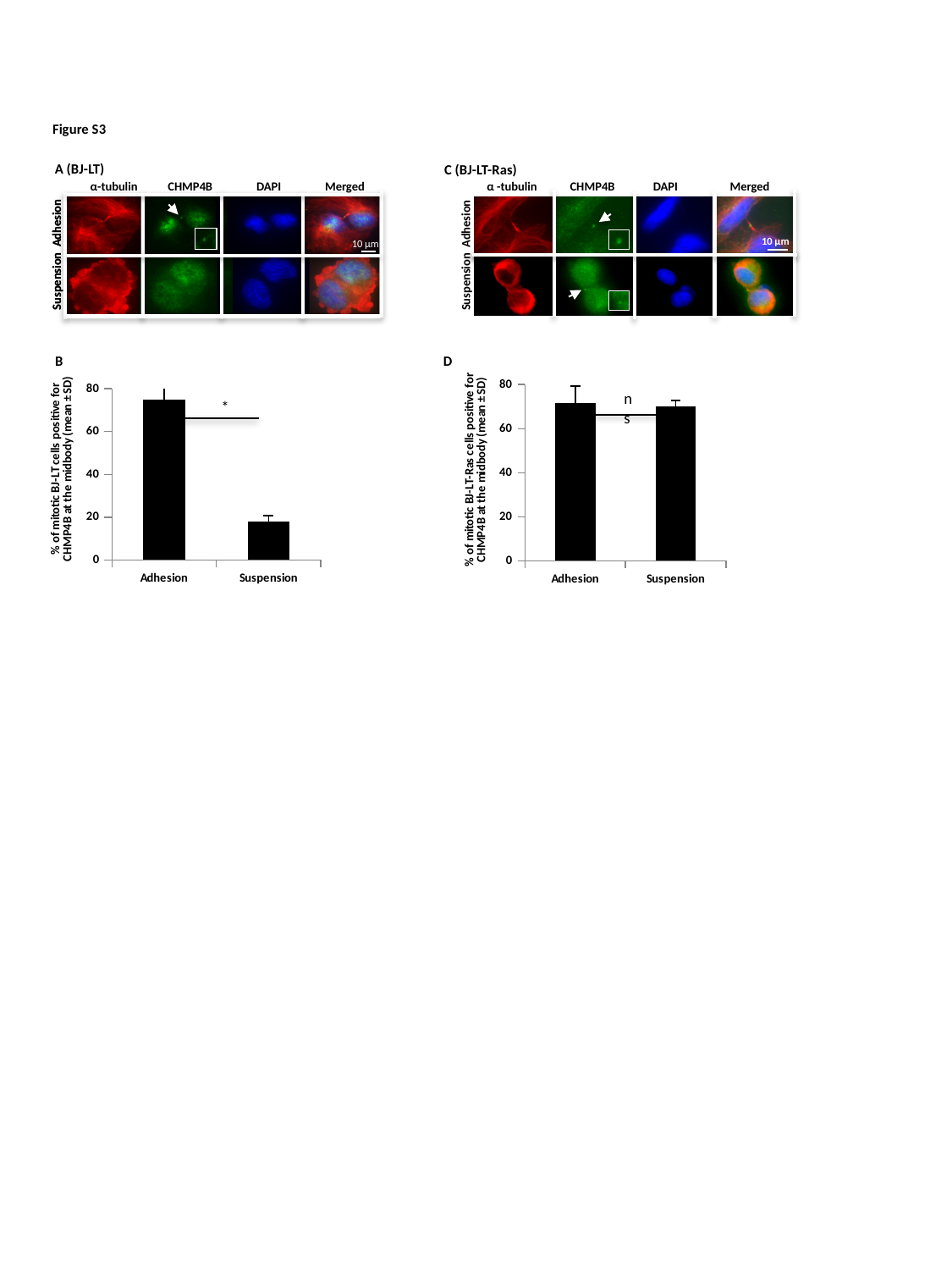
How many categories are shown in chart B (BJ-LT)? 2 What kind of chart is chart D (BJ-LT-Ras)? bar chart In chart B (BJ-LT), is the value for Adhesion greater or less than 60? greater What are the two category labels on the x axis of chart D (BJ-LT-Ras)? Adhesion and Suspension In chart B (BJ-LT), do the values rise or fall from Adhesion to Suspension? fall What is the highest tick value shown on the y axis of chart B (BJ-LT)? 80 In chart B (BJ-LT), which category has the lowest value? Suspension In chart B (BJ-LT), is the value for Suspension greater or less than 40? less In chart D (BJ-LT-Ras), is the value for Suspension greater or less than 40? greater How many categories are shown in chart D (BJ-LT-Ras)? 2 In chart B (BJ-LT), which category has the higher value, Adhesion or Suspension? Adhesion